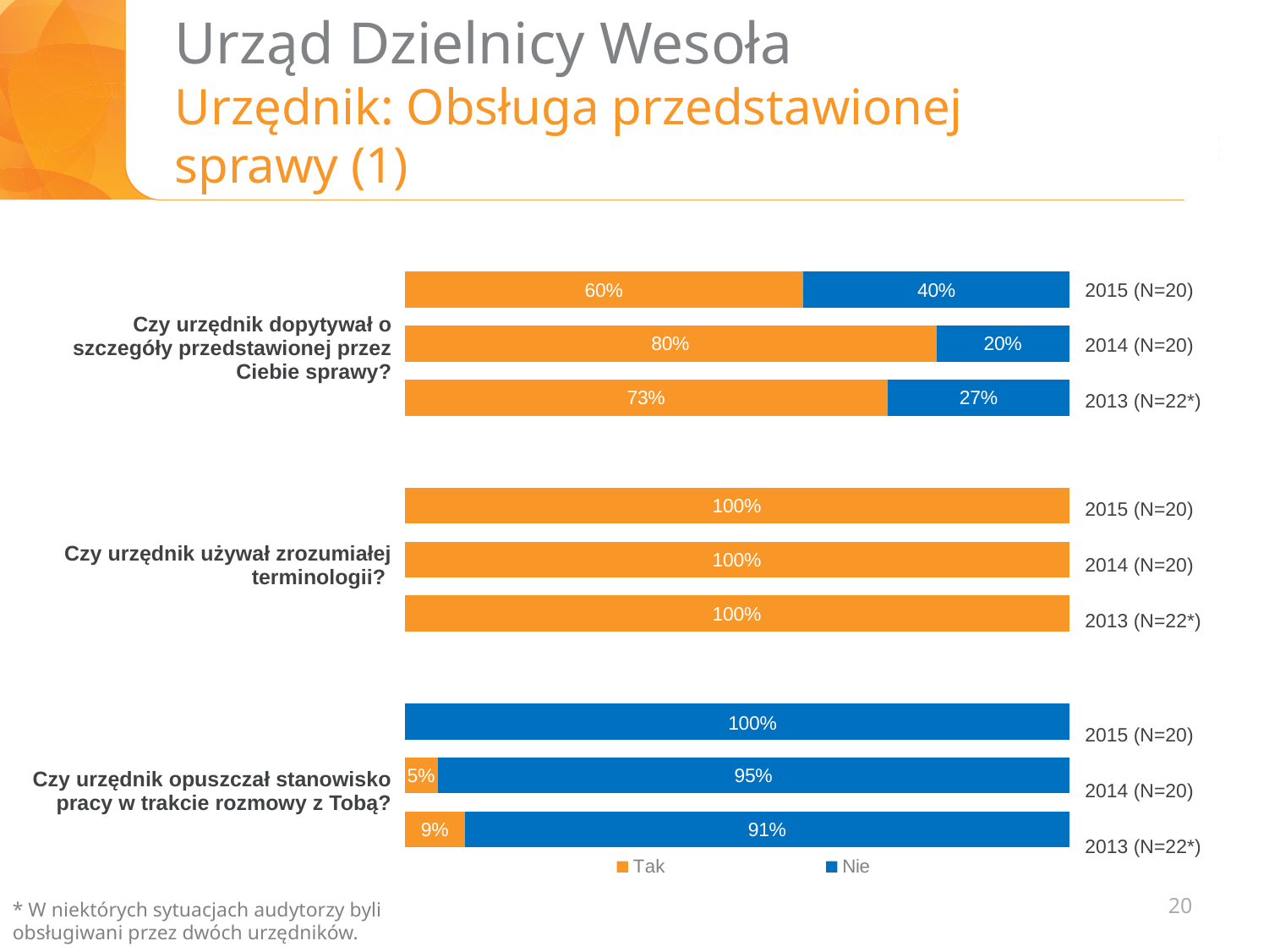
For the question "Czy urzędnik opuszczał stanowisko pracy w trakcie rozmowy z Tobą?", what is the "Tak" value for 2013 (N=22*)? 9% For the question "Czy urzędnik dopytywał o szczegóły przedstawionej przez Ciebie sprawy?", what is the "Nie" value for 2013 (N=22*)? 27% For the question "Czy urzędnik opuszczał stanowisko pracy w trakcie rozmowy z Tobą?", is the "Nie" value for 2014 (N=20) larger or smaller than the "Nie" value for 2013 (N=22*)? Larger How many bars are plotted on the chart in total? 9 For the question "Czy urzędnik opuszczał stanowisko pracy w trakcie rozmowy z Tobą?", what is the "Nie" value for 2015 (N=20)? 100% For the question "Czy urzędnik dopytywał o szczegóły przedstawionej przez Ciebie sprawy?", what is the "Tak" value for 2015 (N=20)? 60% For the question "Czy urzędnik dopytywał o szczegóły przedstawionej przez Ciebie sprawy?", which year has the highest "Tak" value? 2014 (N=20) What are the two series named in the legend? Tak and Nie What type of chart is shown on the slide? Stacked bar chart For the question "Czy urzędnik dopytywał o szczegóły przedstawionej przez Ciebie sprawy?", what is the difference between the "Tak" values for 2014 and 2015? 20 percentage points For the question "Czy urzędnik używał zrozumiałej terminologii?", what is the "Tak" value for 2014 (N=20)? 100% How many series does the legend list? 2